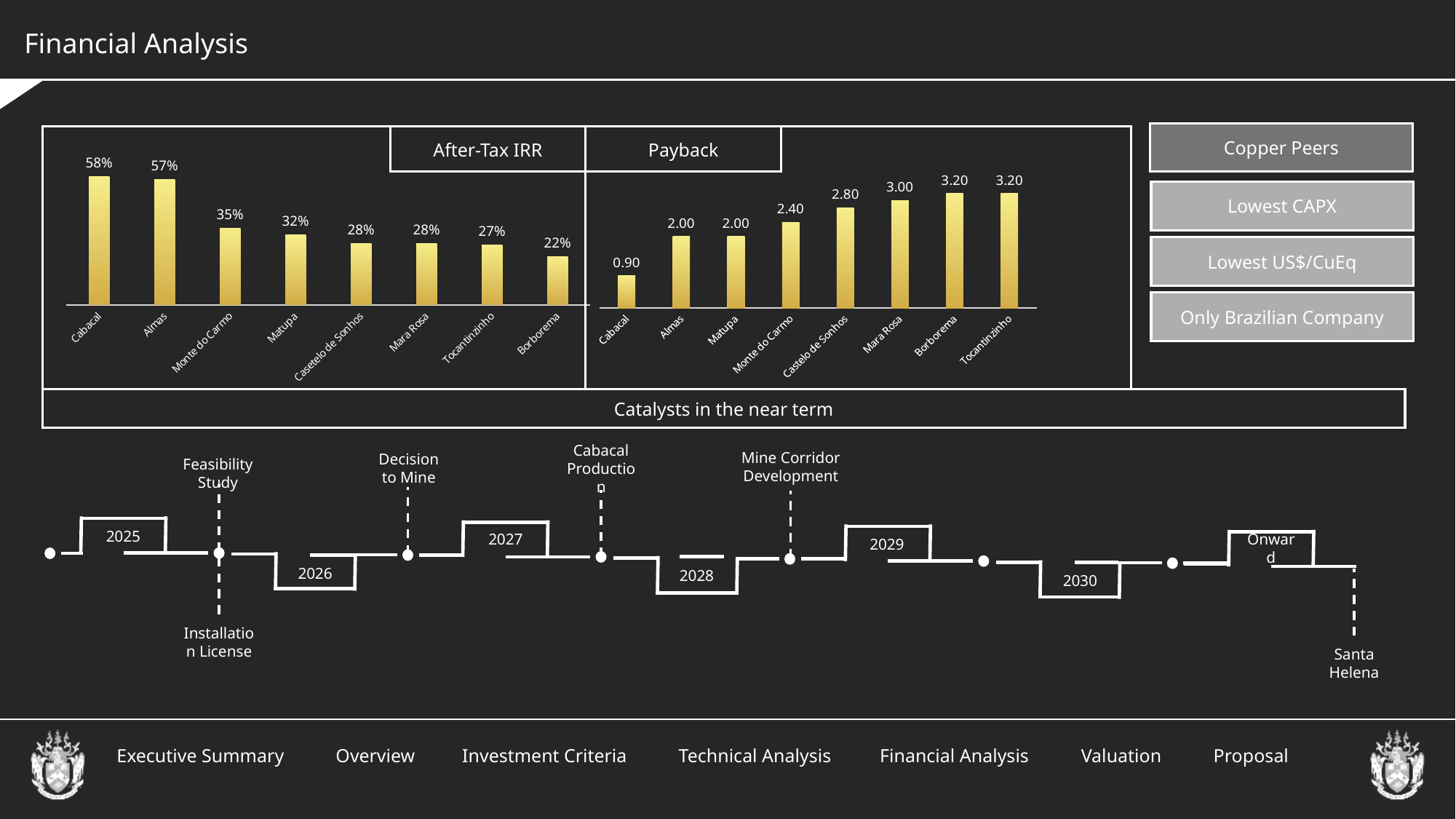
In the After-Tax IRR chart, what is the value for Cabacal? 58% In the After-Tax IRR chart, which category has the lowest value? Borborema What type of chart is the Payback chart? bar chart In the After-Tax IRR chart, how many categories are shown? 8 In the Payback chart, which category has the lowest value? Cabacal In the After-Tax IRR chart, what is the difference between Almas and Matupa? 25% In the Payback chart, which is larger, Monte do Carmo or Mara Rosa? Mara Rosa In the After-Tax IRR chart, do the values rise or fall from left to right? fall In the Payback chart, what is the value for Castelo de Sonhos? 2.80 In the Payback chart, what is the value for Cabacal? 0.90 In the Payback chart, what is the difference between Tocantinzinho and Almas? 1.20 In the After-Tax IRR chart, what is the value for Monte do Carmo? 35%